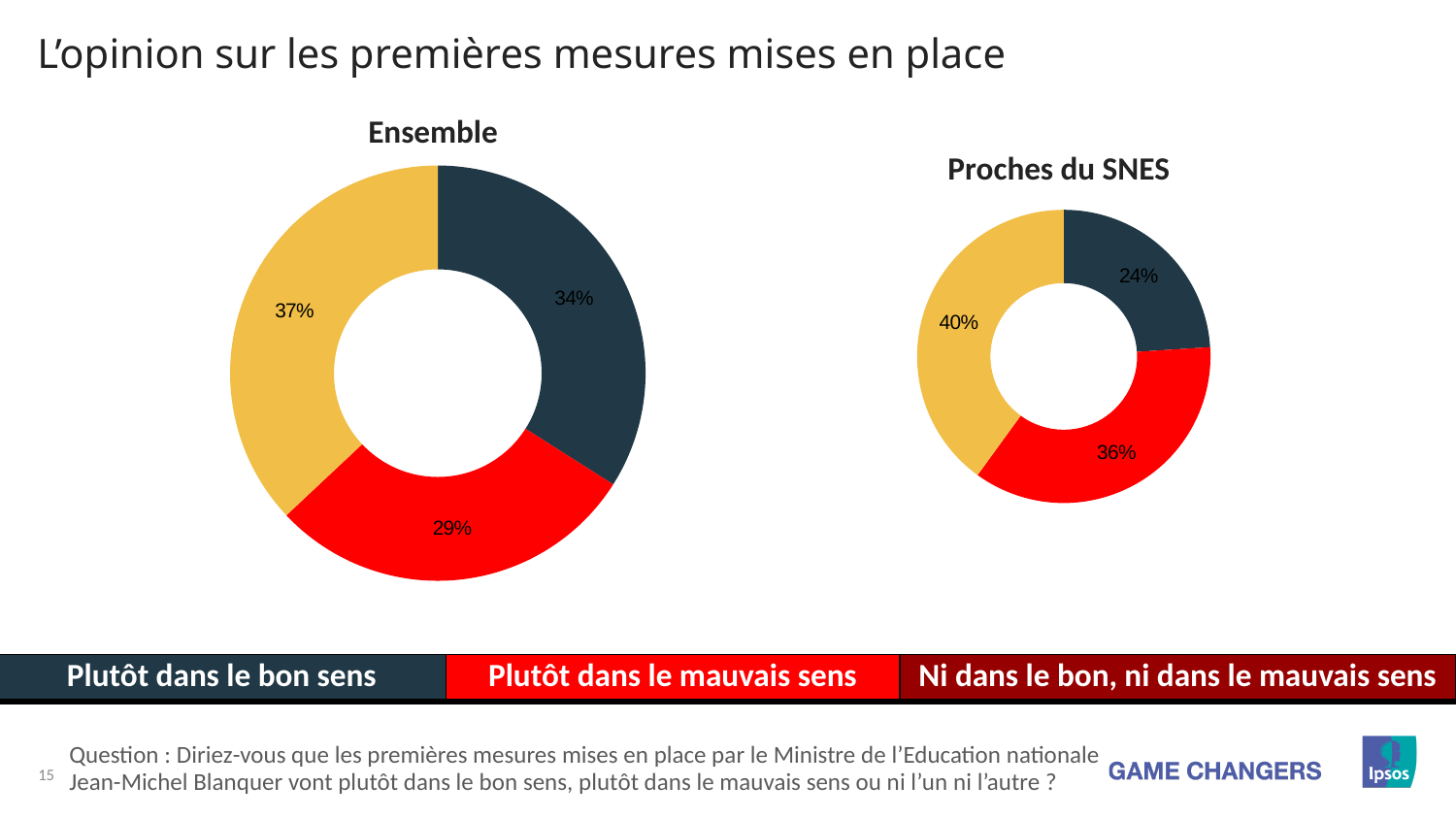
In the "Proches du SNES" chart, which is larger: the share for "Plutôt dans le mauvais sens" or for "Plutôt dans le bon sens"? Plutôt dans le mauvais sens In the "Proches du SNES" chart, what share of respondents answered "Plutôt dans le bon sens"? 24% In the "Ensemble" chart, which response has the largest share? Ni dans le bon, ni dans le mauvais sens What type of chart is used on this slide? Donut (pie) chart In the "Proches du SNES" chart, which response has the smallest share? Plutôt dans le bon sens How many slices does the "Ensemble" chart have? 3 What is the difference between the "Plutôt dans le bon sens" share in the "Ensemble" chart and in the "Proches du SNES" chart? 10 percentage points In the "Ensemble" chart, what share of respondents answered "Plutôt dans le mauvais sens"? 29% What is the title of the chart on the right of the slide? Proches du SNES In the "Proches du SNES" chart, what share of respondents answered "Ni dans le bon, ni dans le mauvais sens"? 40% Which colour represents "Plutôt dans le mauvais sens" in the charts? Red In the "Ensemble" chart, what share of respondents answered "Plutôt dans le bon sens"? 34%